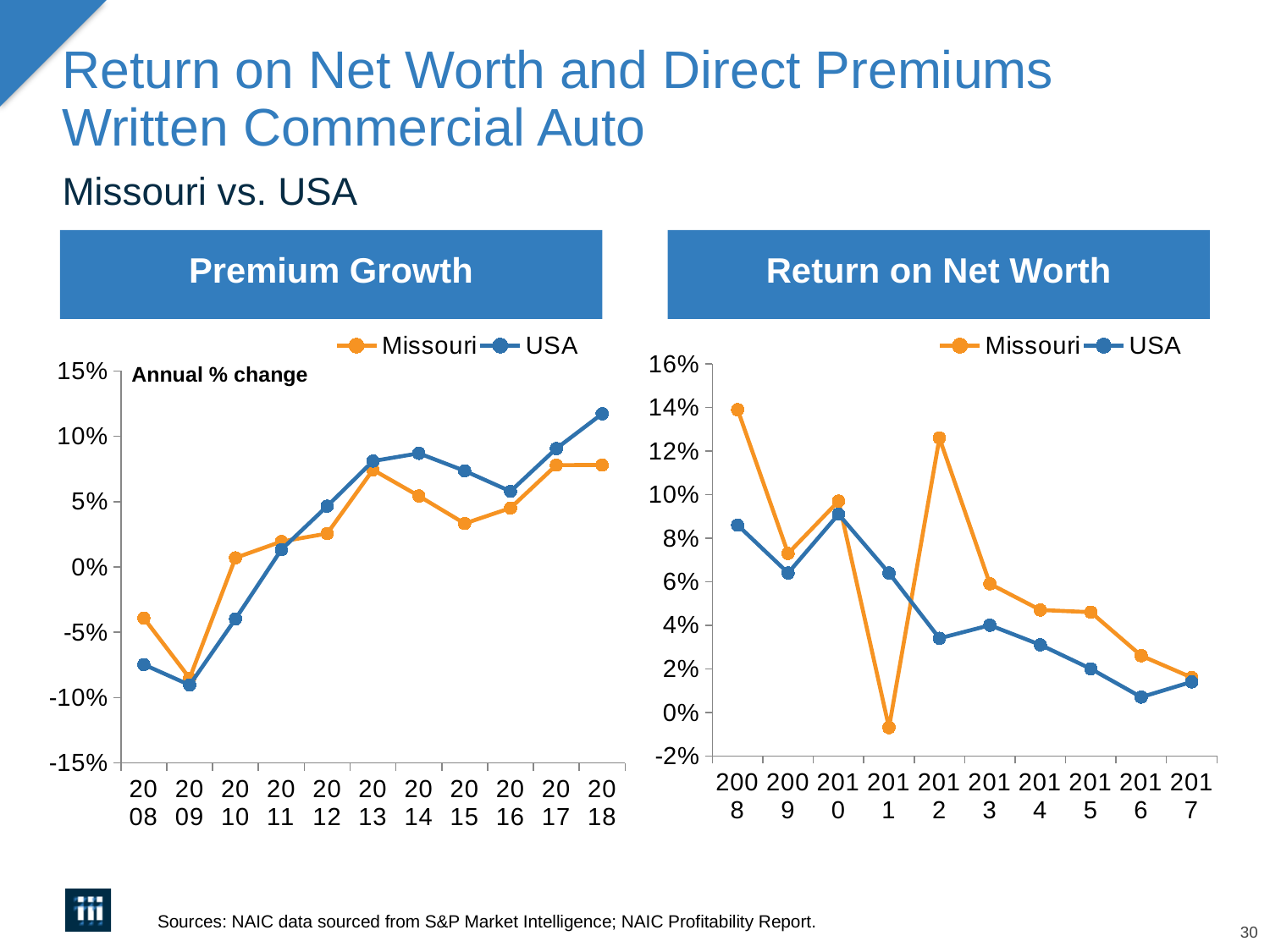
In the Return on Net Worth chart, is the USA value for 2016 greater or less than 2%? less What kind of chart is the Premium Growth chart? Line chart What text is written inside the plot area of the Premium Growth chart near the top of the y axis? Annual % change In the Return on Net Worth chart, which series has the larger value in 2012, Missouri or USA? Missouri How many years are plotted on the x axis of the Premium Growth chart? 11 How many series does the legend of the Return on Net Worth chart list? 2 In the Return on Net Worth chart, is the Missouri value for 2011 greater or less than 0%? less In the Premium Growth chart, is the USA value for 2018 greater or less than 10%? greater In the Return on Net Worth chart, which year has the highest Missouri value? 2008 In the Premium Growth chart, which year has the lowest USA value? 2009 How many years are plotted on the x axis of the Return on Net Worth chart? 10 In the Premium Growth chart, does the Missouri line rise or fall from 2009 to 2013? rise